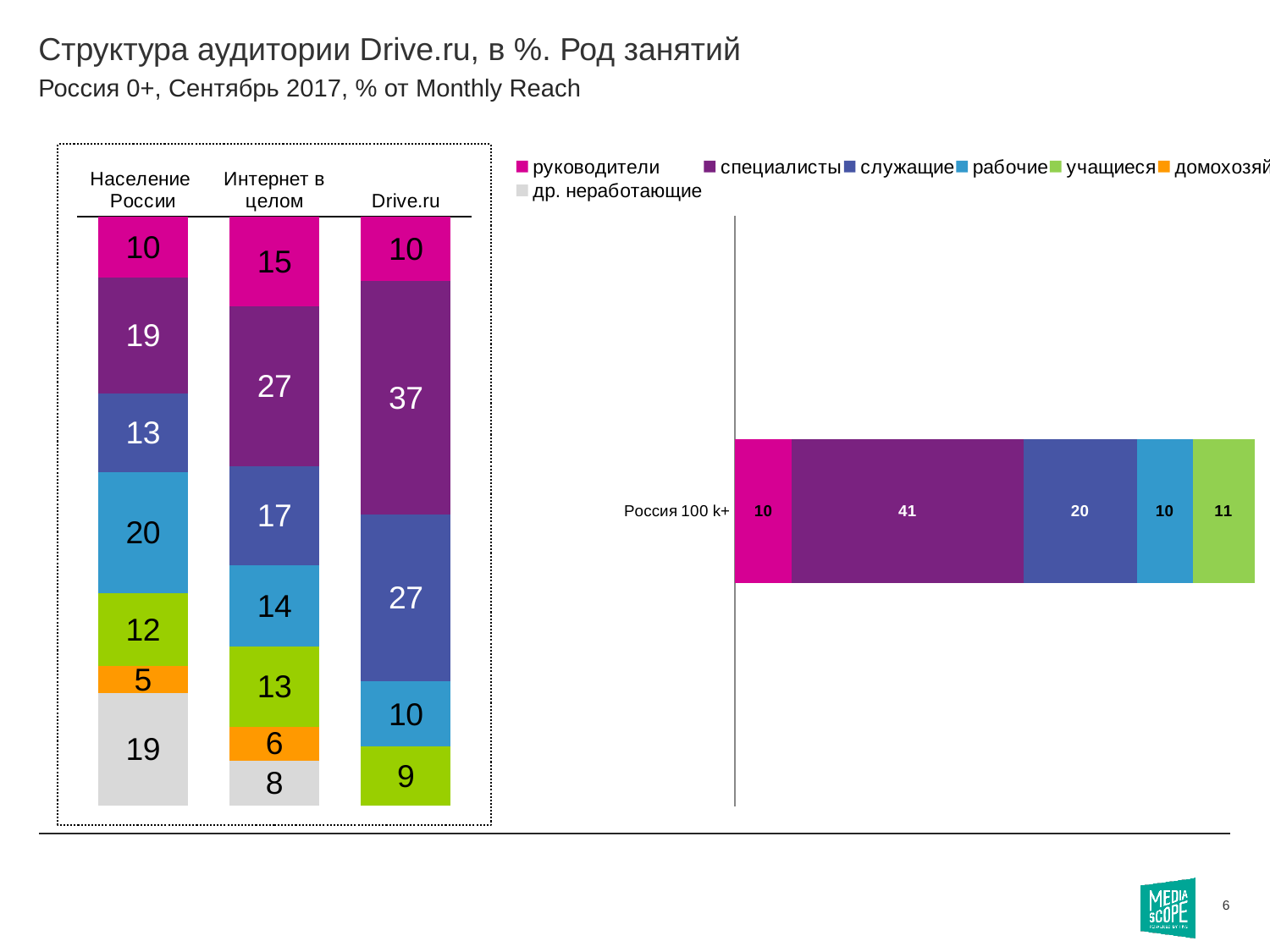
In the left chart, which segment is the largest in the Drive.ru bar? специалисты In the right chart, what is the value of the специалисты segment for Россия 100 k+? 41 What type of chart is the right chart (Россия 100 k+)? Stacked bar chart In the left chart, what is the value of the рабочие segment for Население России? 20 How many series does the legend list? 7 How many bars (columns) does the left chart show? 3 In the left chart, what is the value of the специалисты segment for Drive.ru? 37 In the left chart, what is the difference between the служащие values for Drive.ru and Население России? 14 In the left chart, what is the value of the др. неработающие segment for Интернет в целом? 8 In the left chart, which is larger: the учащиеся value for Интернет в целом or for Drive.ru? Интернет в целом In the left chart, which segment is the smallest in the Население России bar? домохозяйки (orange segment) In the left chart, what is the value of the руководители segment for Интернет в целом? 15